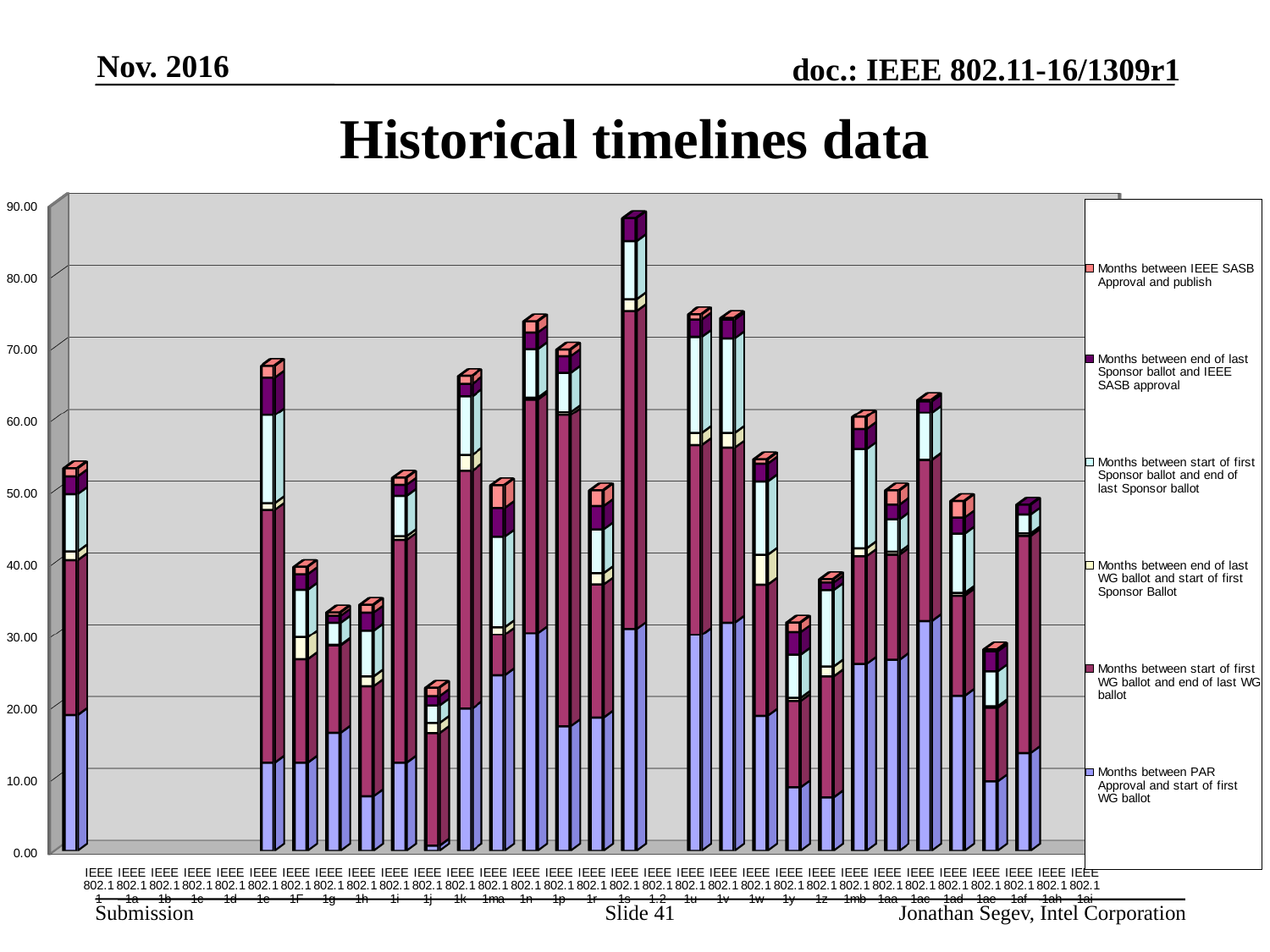
Which category has the tallest stacked bar? IEEE 802.1 1s Is the total for IEEE 802.1 1u greater or less than 70.00? greater Which series forms the bottom segment of each stacked bar? Months between PAR Approval and start of first WG ballot How many series does the legend list? 6 Is the total for IEEE 802.1 1j greater or less than 30.00? less Among the categories with a plotted bar, which has the shortest stacked bar? IEEE 802.1 1j Which has the taller stacked bar, IEEE 802.1 1e or IEEE 802.1 1F? IEEE 802.1 1e Which has the taller stacked bar, IEEE 802.1 1y or IEEE 802.1 1mb? IEEE 802.1 1mb What is the title of the chart? Historical timelines data Is the total for IEEE 802.1 1s greater or less than 80.00? greater What kind of chart is shown on the slide? Stacked bar chart